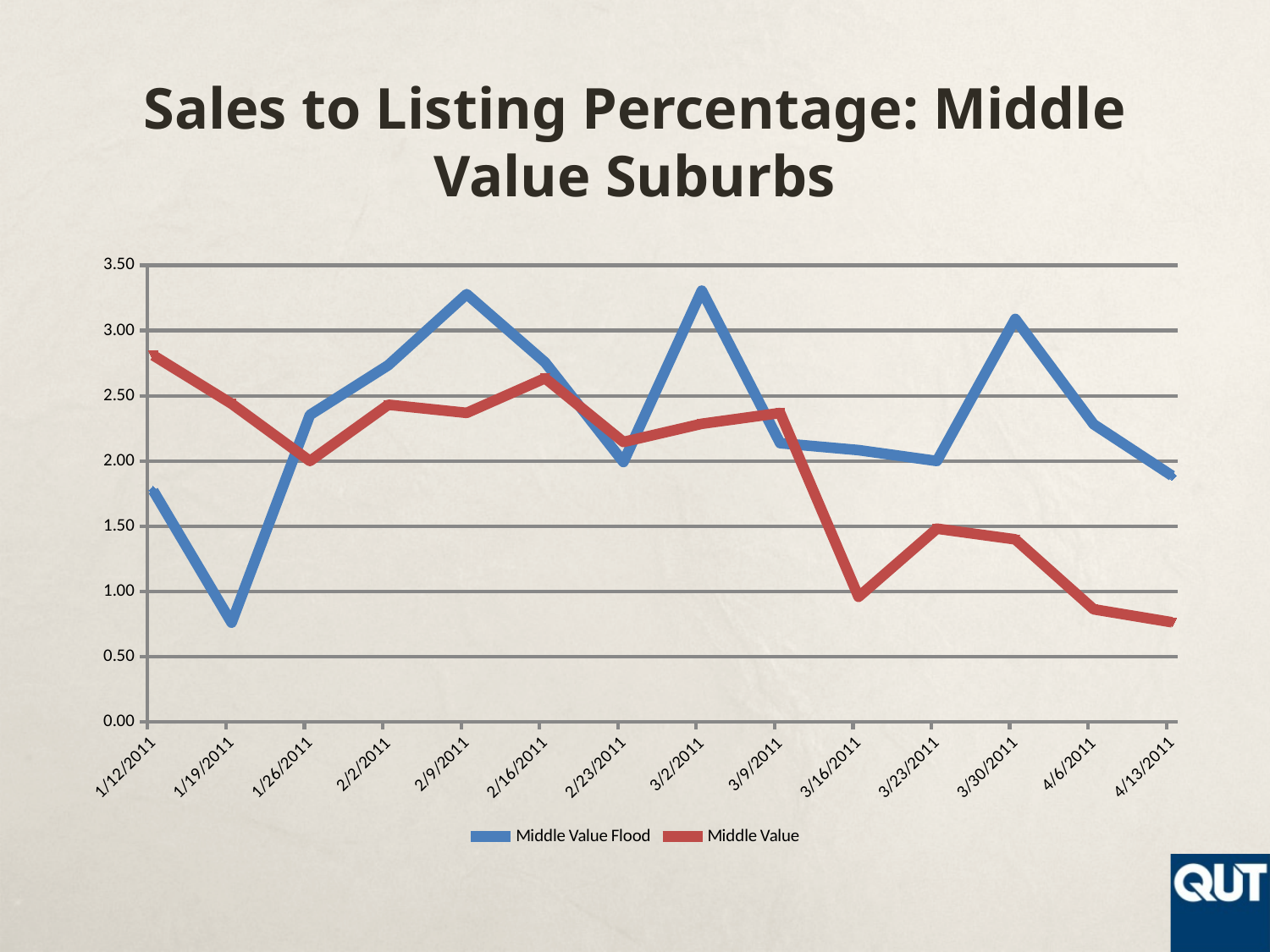
Is the value for Middle Value on 1/12/2011 greater or less than 2.50? greater On 1/12/2011, which series has the higher value, Middle Value Flood or Middle Value? Middle Value Is the value for Middle Value Flood on 1/19/2011 greater or less than 1.00? less How many series does the legend list? 2 Is the value for Middle Value Flood on 3/30/2011 greater or less than 3.00? greater On which date is the Middle Value series at its highest? 1/12/2011 Does the Middle Value series rise or fall between 3/9/2011 and 3/16/2011? fall On 4/13/2011, which series has the higher value, Middle Value Flood or Middle Value? Middle Value Flood How many dates are plotted along the x axis? 14 What kind of chart is shown on the slide? line chart On which date is the Middle Value Flood series at its lowest? 1/19/2011